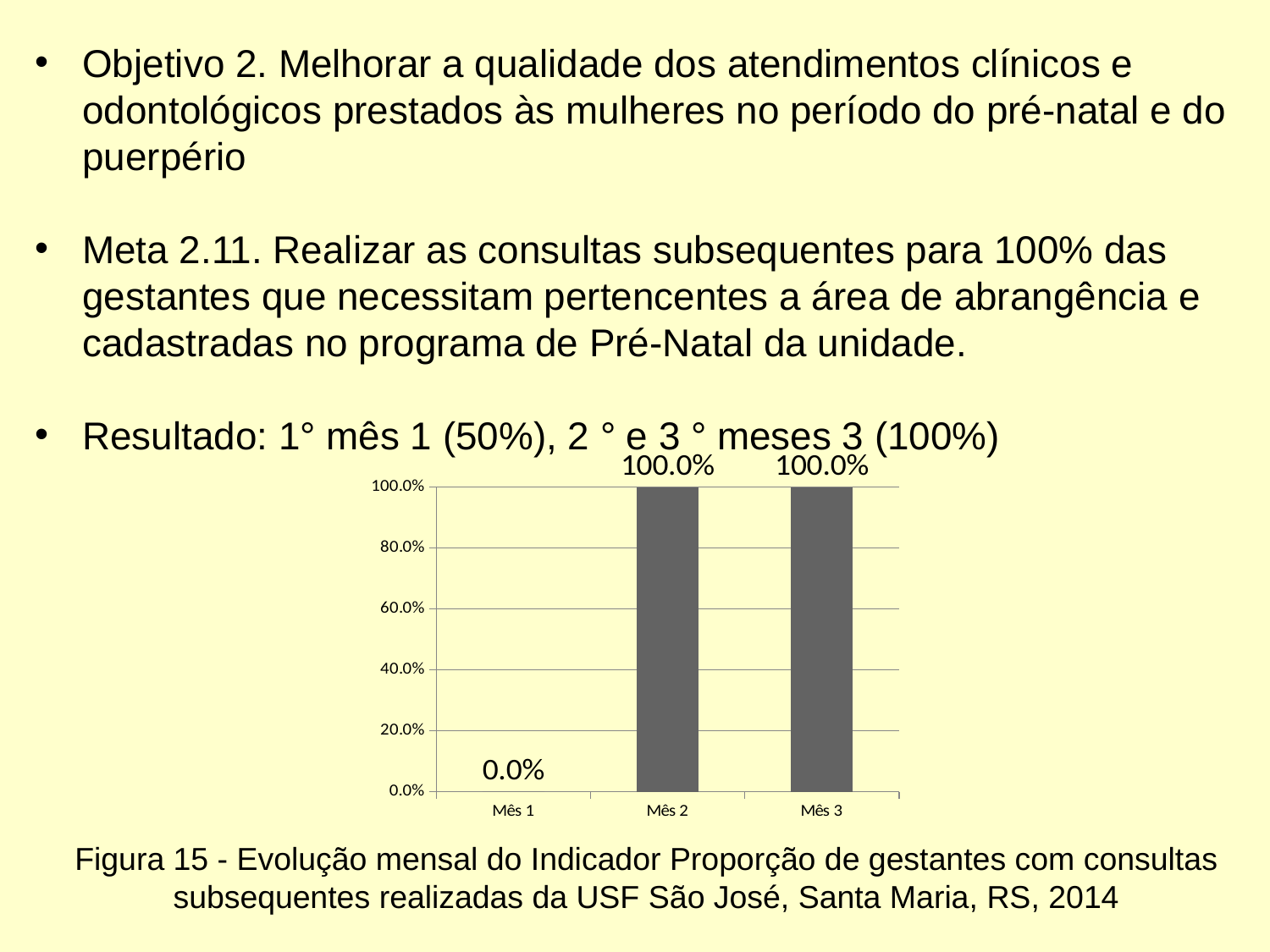
Which category has the lowest value in the chart? Mês 1 What is the value for Mês 1 in the chart? 0.0% What is the value for Mês 2 in the chart? 100.0% Is the value for Mês 2 greater or less than 80.0%? greater What is the difference between the values for Mês 2 and Mês 1? 100.0% What kind of chart is shown on the slide? bar chart What is the highest value shown on the y axis of the chart? 100.0% Do the values rise or fall from Mês 1 to Mês 2? rise How many categories are shown on the x axis of the chart? 3 Which is larger, the value for Mês 1 or the value for Mês 3? Mês 3 What is the value for Mês 3 in the chart? 100.0% Is the value for Mês 1 greater or less than 20.0%? less